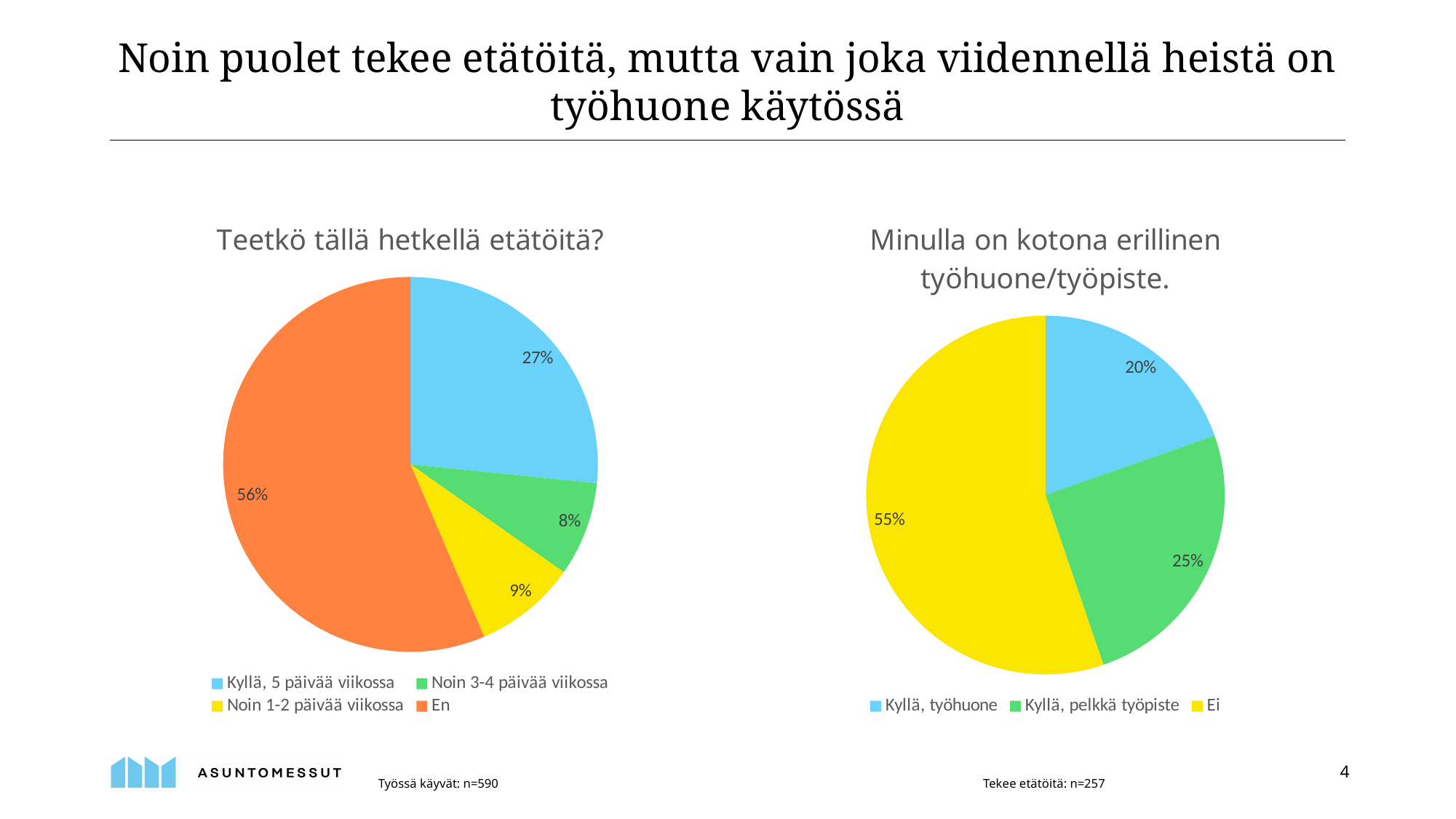
In the chart titled "Teetkö tällä hetkellä etätöitä?", what is the difference between "En" and "Kyllä, 5 päivää viikossa"? 29% In the chart titled "Minulla on kotona erillinen työhuone/työpiste.", how many categories does the legend list? 3 In the chart titled "Teetkö tällä hetkellä etätöitä?", how many categories does the legend list? 4 In the chart titled "Minulla on kotona erillinen työhuone/työpiste.", which is larger, "Kyllä, työhuone" or "Kyllä, pelkkä työpiste"? Kyllä, pelkkä työpiste In the chart titled "Teetkö tällä hetkellä etätöitä?", what is the value for "Kyllä, 5 päivää viikossa"? 27% In the chart titled "Teetkö tällä hetkellä etätöitä?", which category has the smallest slice? Noin 3-4 päivää viikossa In the chart titled "Teetkö tällä hetkellä etätöitä?", what colour is the "Noin 1-2 päivää viikossa" slice? Yellow In the chart titled "Minulla on kotona erillinen työhuone/työpiste.", what is the value for "Ei"? 55% In the chart titled "Minulla on kotona erillinen työhuone/työpiste.", what is the difference between "Kyllä, pelkkä työpiste" and "Kyllä, työhuone"? 5% What kind of chart is the chart on the left of the slide? Pie chart In the chart titled "Teetkö tällä hetkellä etätöitä?", what share of the pie is "En"? 56% In the chart titled "Minulla on kotona erillinen työhuone/työpiste.", which category has the largest slice? Ei